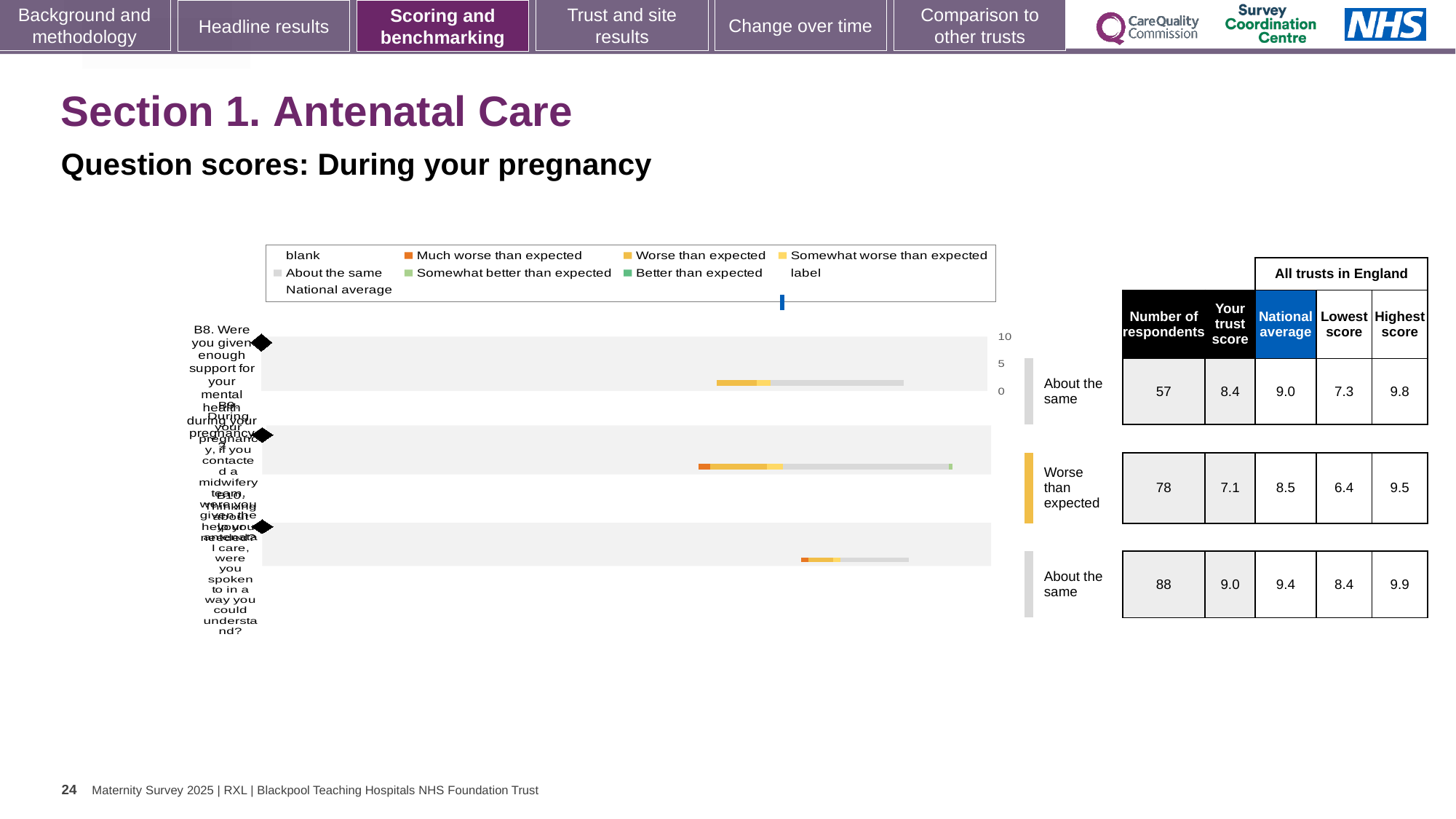
Which row in the table has the highest 'Your trust score'? the third row (9.0) For the first row, which is larger: the trust score or the national average? the national average (9.0) In the table next to the chart, what is the 'Your trust score' for the first row (B8, support for your mental health during pregnancy)? 8.4 For the second row, what is the difference between the national average and the trust score? 1.4 How many survey questions (rows) are plotted in the chart? 3 What is the highest score among all trusts in England for the third row? 9.9 What is the lowest score among all trusts in England for the first row? 7.3 In the table, what is the number of respondents for the second row? 78 Which row in the table has the lowest 'Your trust score'? the second row (7.1) What kind of chart is shown on the slide? bar chart In the table, what is the national average for the third row? 9.4 What benchmark category is shown for the second row of the chart? Worse than expected